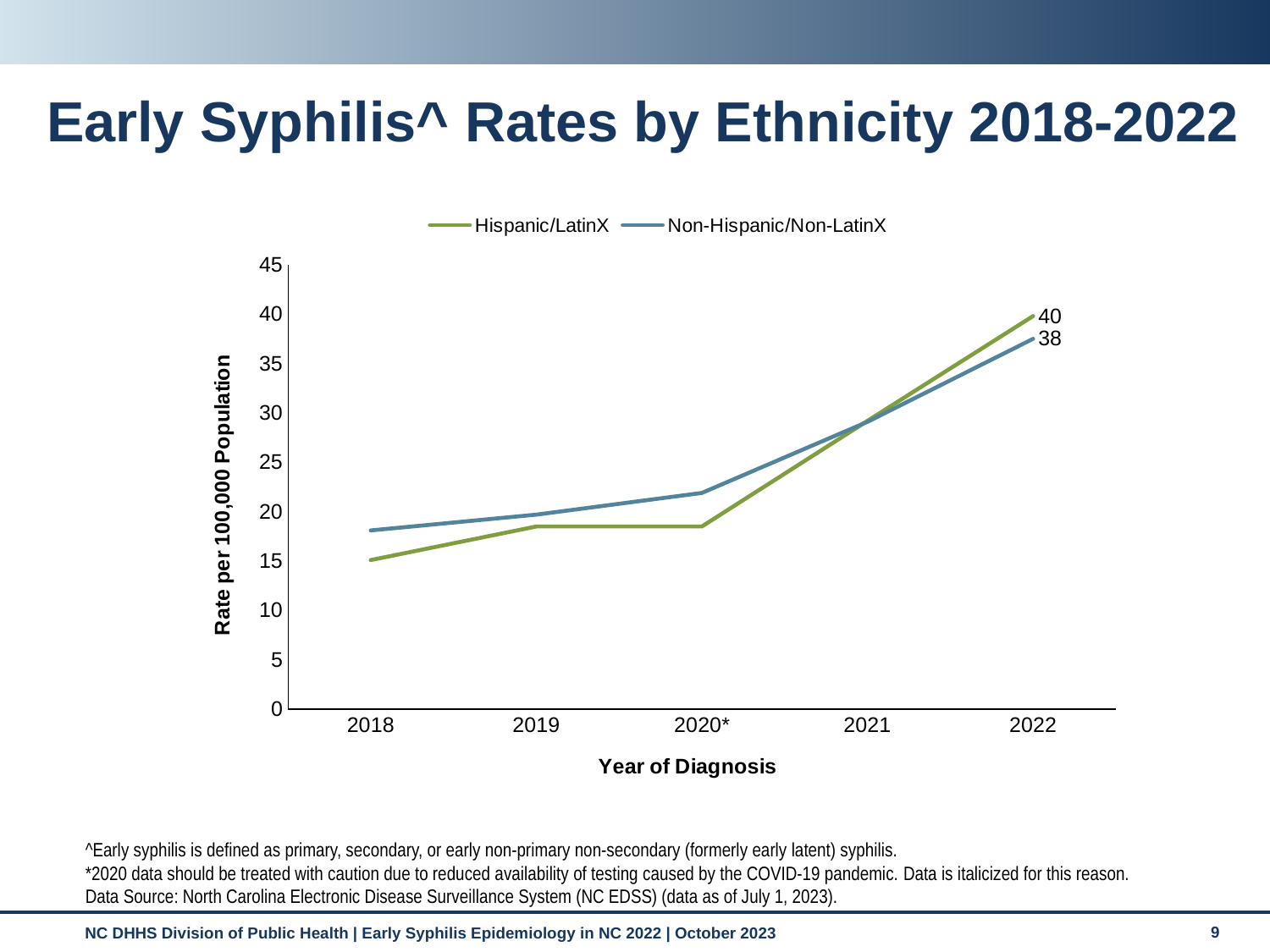
Is the Non-Hispanic/Non-LatinX rate in 2020* greater or less than 20? greater Is the Non-Hispanic/Non-LatinX rate in 2018 greater or less than 20? less What is the difference between the Hispanic/LatinX and Non-Hispanic/Non-LatinX rates in 2022? 2 What is the early syphilis rate for Hispanic/LatinX in 2022? 40 Do the rates for both groups generally rise or fall from 2018 to 2022? rise What is the title of the y axis? Rate per 100,000 Population How many years are plotted along the x axis? 5 Which group has the higher rate in 2022, Hispanic/LatinX or Non-Hispanic/Non-LatinX? Hispanic/LatinX What is the early syphilis rate for Non-Hispanic/Non-LatinX in 2022? 38 What kind of chart is shown on the slide? line chart How many series does the legend list? 2 Is the Hispanic/LatinX rate in 2020* greater or less than 20? less